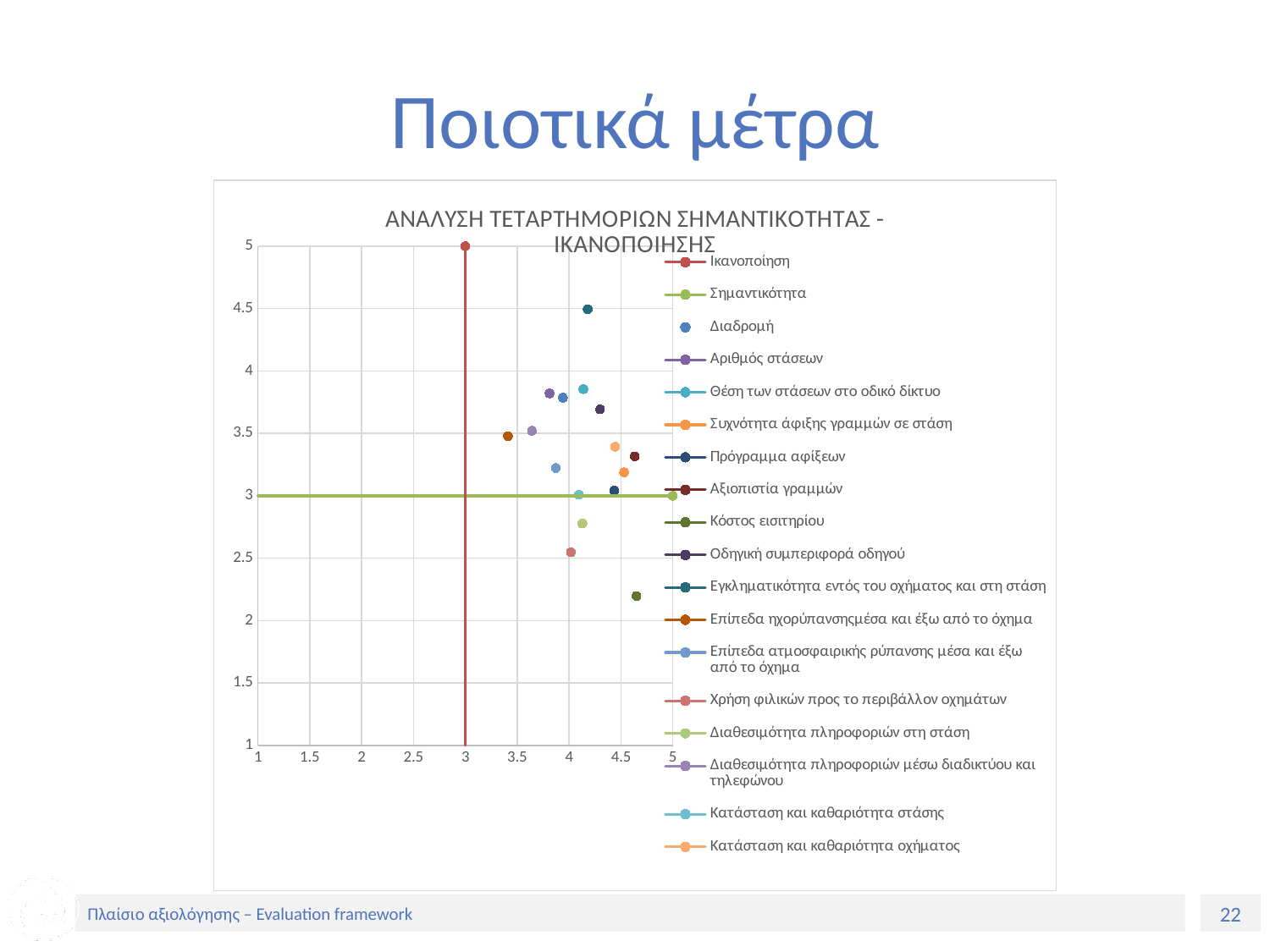
Is the vertical-axis value for Εγκληματικότητα εντός του οχήματος και στη στάση greater or less than 4? greater How many series does the legend list? 18 Is the horizontal-axis value for Κόστος εισιτηρίου greater or less than 4.5? greater What is the highest value shown on the vertical axis? 5 Is the vertical-axis value for Χρήση φιλικών προς το περιβάλλον οχημάτων greater or less than 3? less What kind of chart is shown on the slide? scatter chart Which of the two has the higher vertical-axis value: Εγκληματικότητα εντός του οχήματος και στη στάση or Κόστος εισιτηρίου? Εγκληματικότητα εντός του οχήματος και στη στάση What is the title of the chart? ΑΝΑΛΥΣΗ ΤΕΤΑΡΤΗΜΟΡΙΩΝ ΣΗΜΑΝΤΙΚΟΤΗΤΑΣ - ΙΚΑΝΟΠΟΙΗΣΗΣ